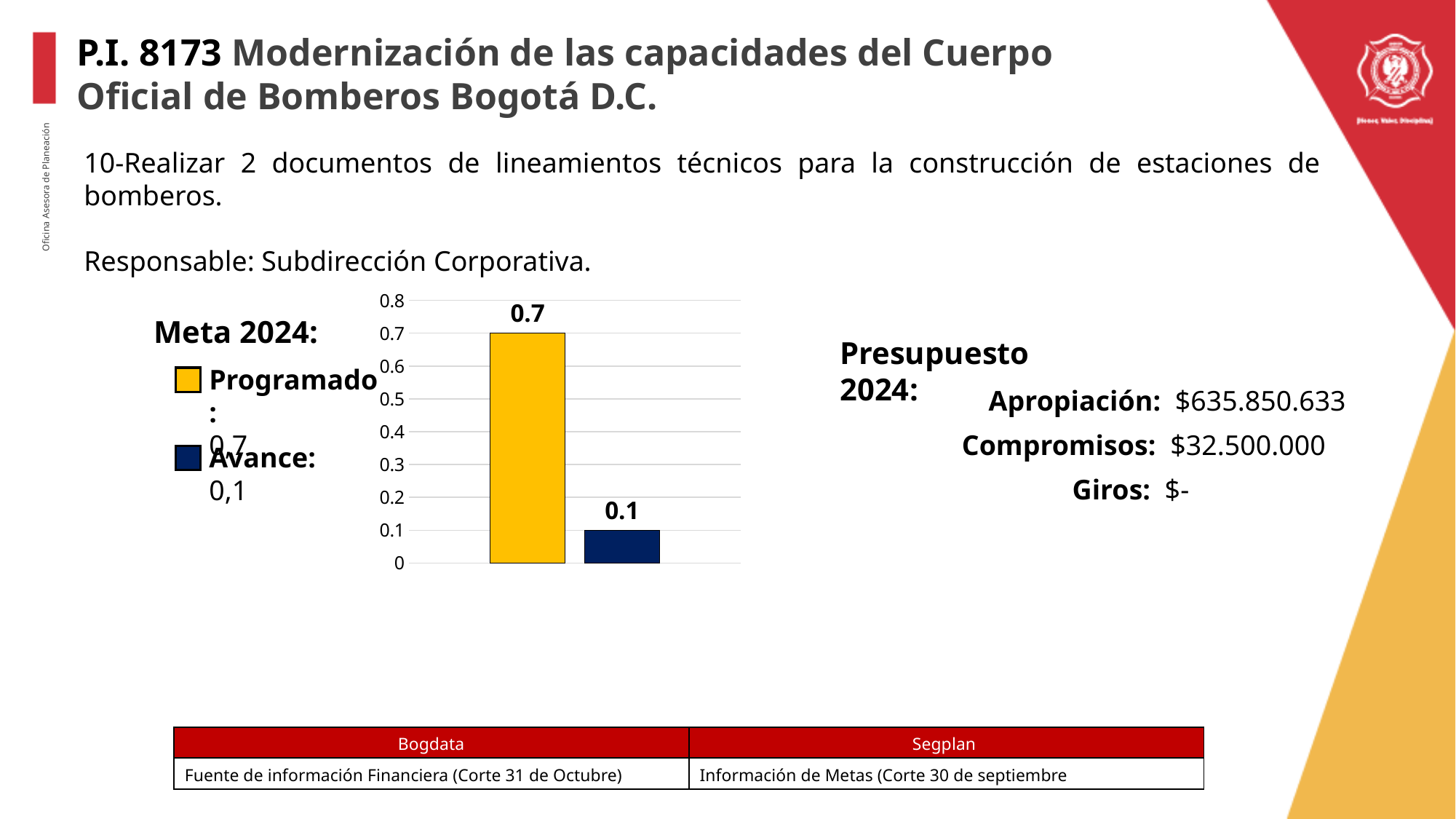
What colour is the Avance bar in the chart? dark blue Which bar is taller in the chart, Programado or Avance? Programado Is the value of the Programado bar greater or less than 0.5? greater What is the maximum value shown on the chart's vertical axis? 0.8 Is the value of the Avance bar greater or less than 0.2? less What is the value of the Avance bar in the chart? 0.1 What is the value of the Programado bar in the chart? 0.7 How many bars are plotted in the chart? 2 Which bar has the lowest value in the chart? Avance What is the difference between the Programado and Avance values in the chart? 0.6 What kind of chart is shown on the slide? bar chart